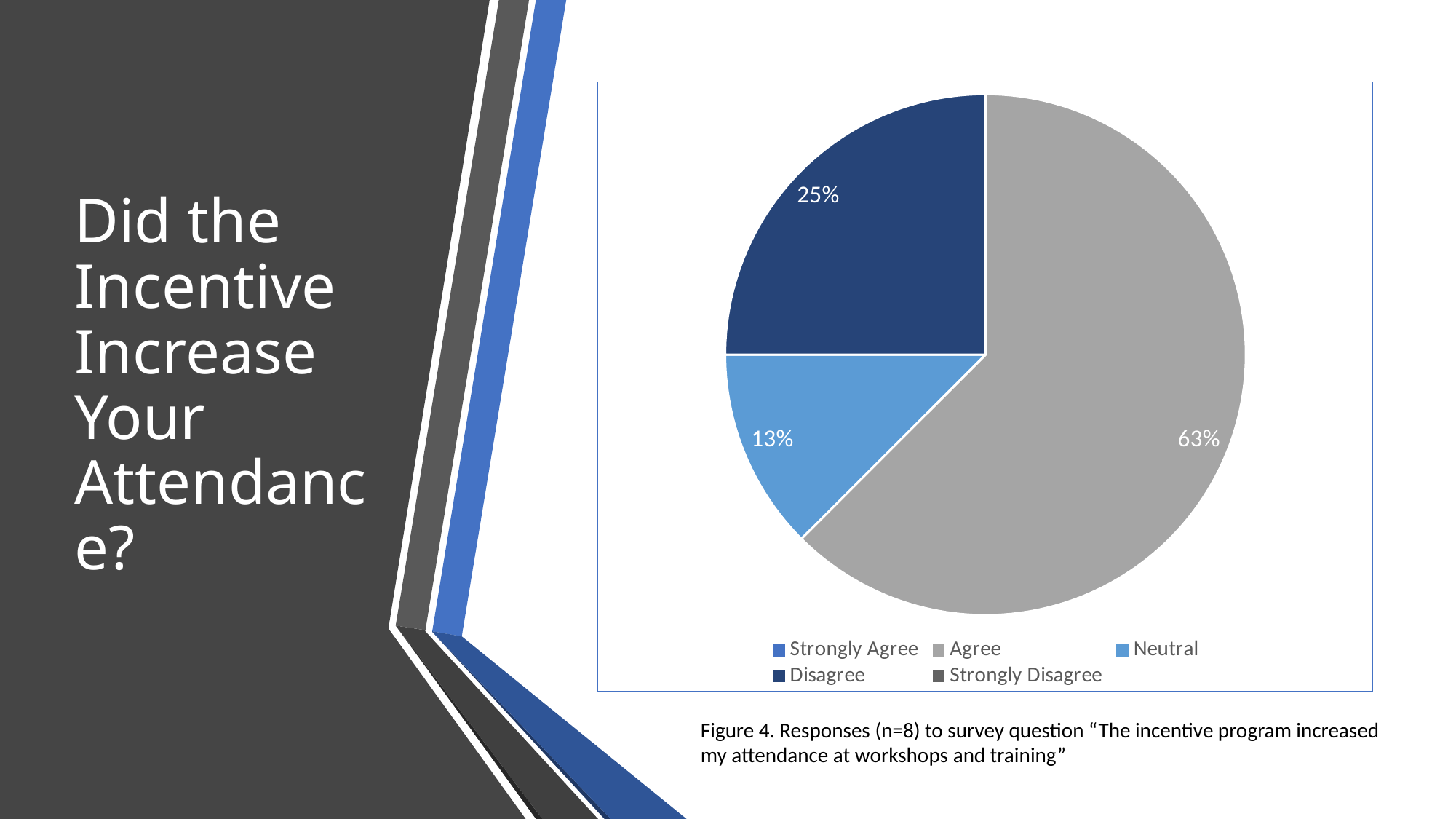
What is the difference in percentage points between the Agree share and the Disagree share? 38 What kind of chart is shown on the slide? pie chart What percentage of responses were "Disagree"? 25% How many entries does the legend list? 5 Which is larger, the share for Disagree or the share for Neutral? Disagree How many slices are visible in the pie? 3 What percentage of responses were "Neutral"? 13% According to the figure caption, how many respondents (n) answered the survey question? 8 Which response category has the largest share of the pie? Agree What percentage of responses were "Agree"? 63% What colour is the Agree slice? gray Which of the visible slices is the smallest? Neutral